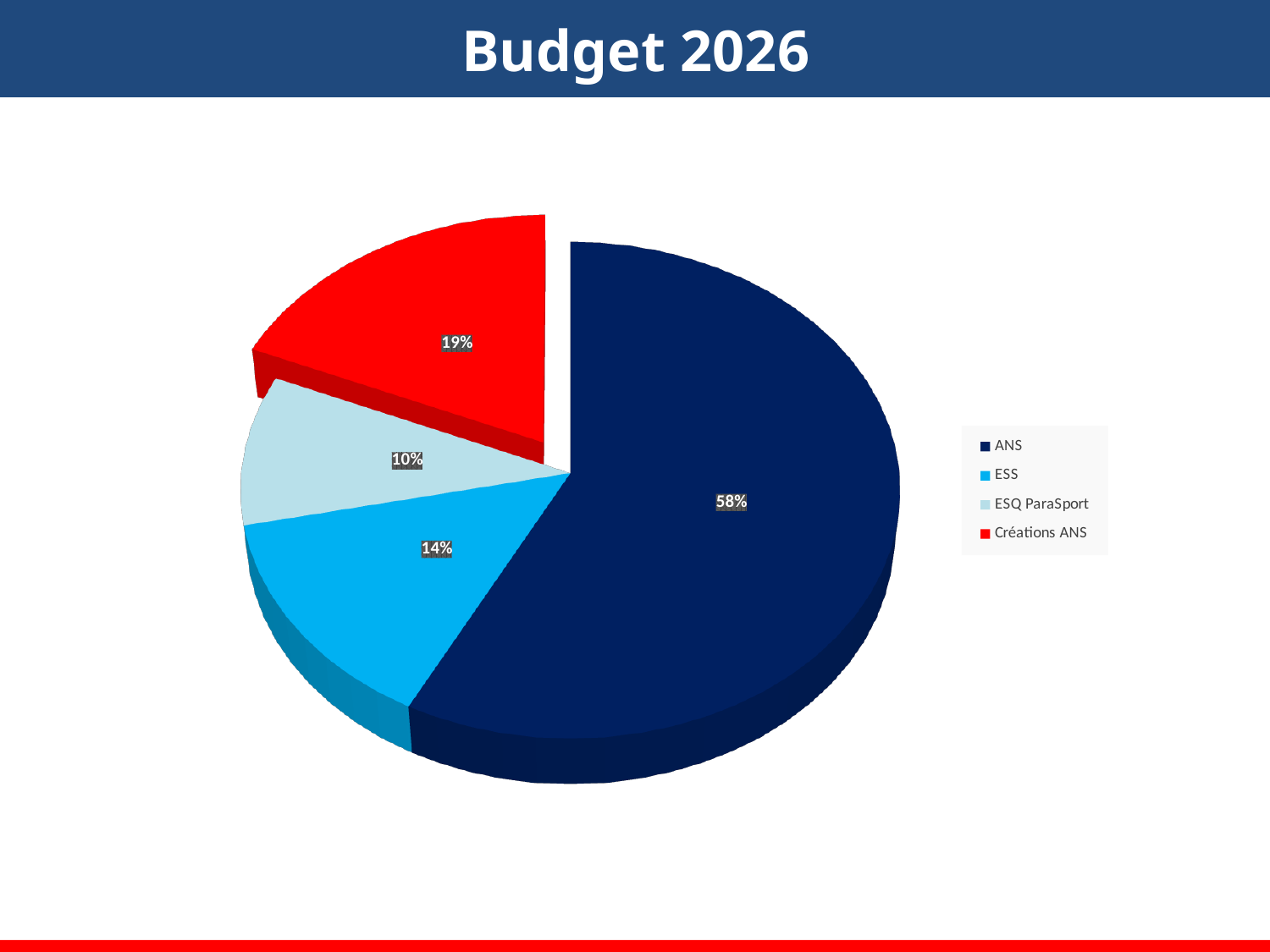
Which is larger, the share for ESS or the share for Créations ANS? Créations ANS What is the title of the slide? Budget 2026 Which category has the largest share of the pie? ANS What share of the pie does Créations ANS represent? 19% What is the difference in percentage points between the ANS share and the Créations ANS share? 39 What kind of chart is shown on the slide? Pie chart How many categories are shown in the pie chart? 4 What share of the pie does ESS represent? 14% What share of the pie does ANS represent? 58% Which category is shown in red in the legend? Créations ANS What share of the pie does ESQ ParaSport represent? 10% Which category has the smallest share of the pie? ESQ ParaSport